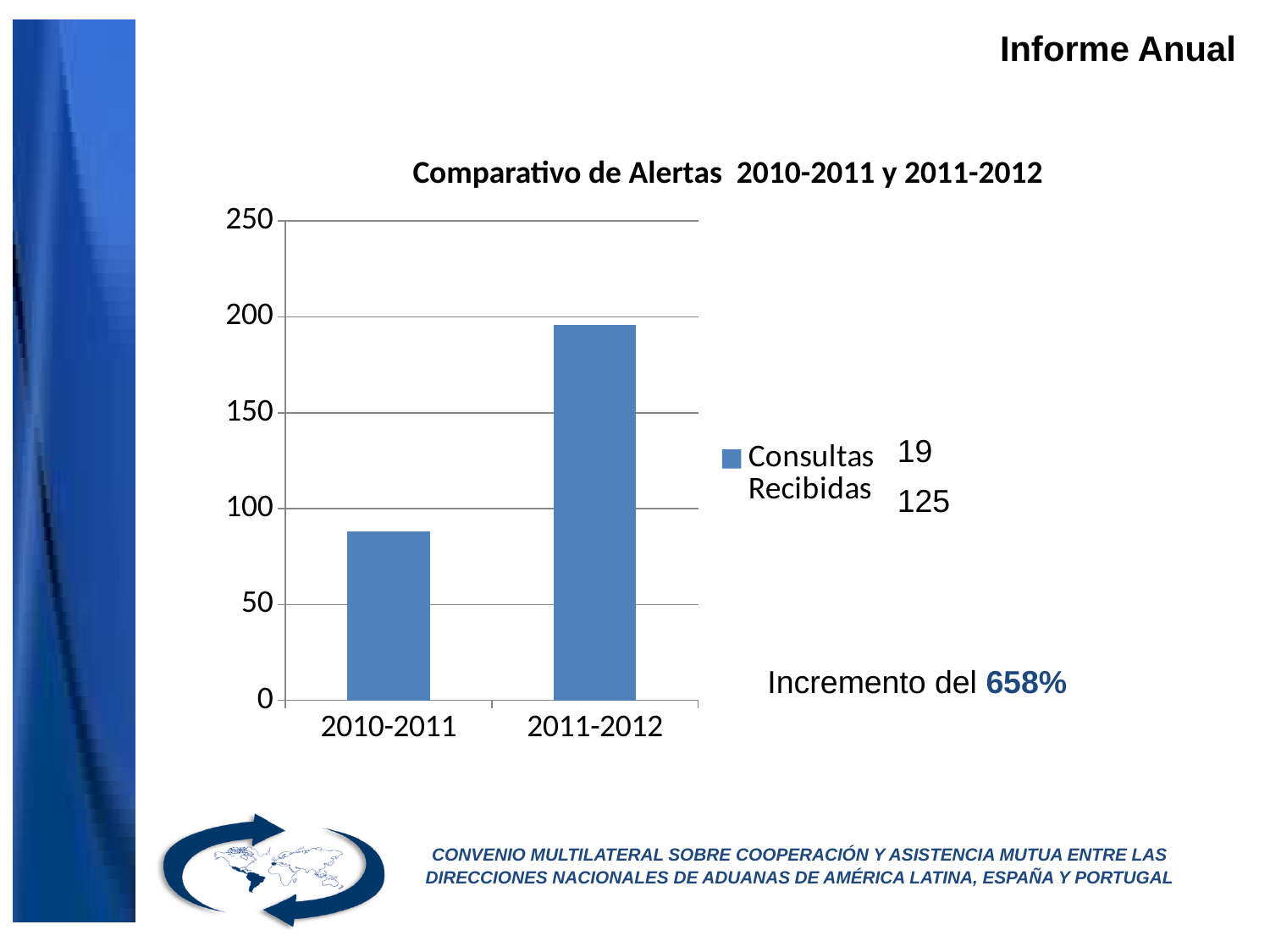
Which period has the highest value in the chart? 2011-2012 Is the value for 2010-2011 greater or less than 100? less What is the title of the chart? Comparativo de Alertas 2010-2011 y 2011-2012 How many series does the chart legend list? 1 What kind of chart is shown on the slide? bar chart What is the name of the series shown in the chart legend? Consultas Recibidas Do the values rise or fall from 2010-2011 to 2011-2012? rise Which period has the lowest value in the chart? 2010-2011 Is the value for 2011-2012 greater or less than 150? greater How many categories are shown on the x axis of the chart? 2 Is the value for 2010-2011 greater or less than 50? greater Which is larger, the value for 2010-2011 or the value for 2011-2012? 2011-2012